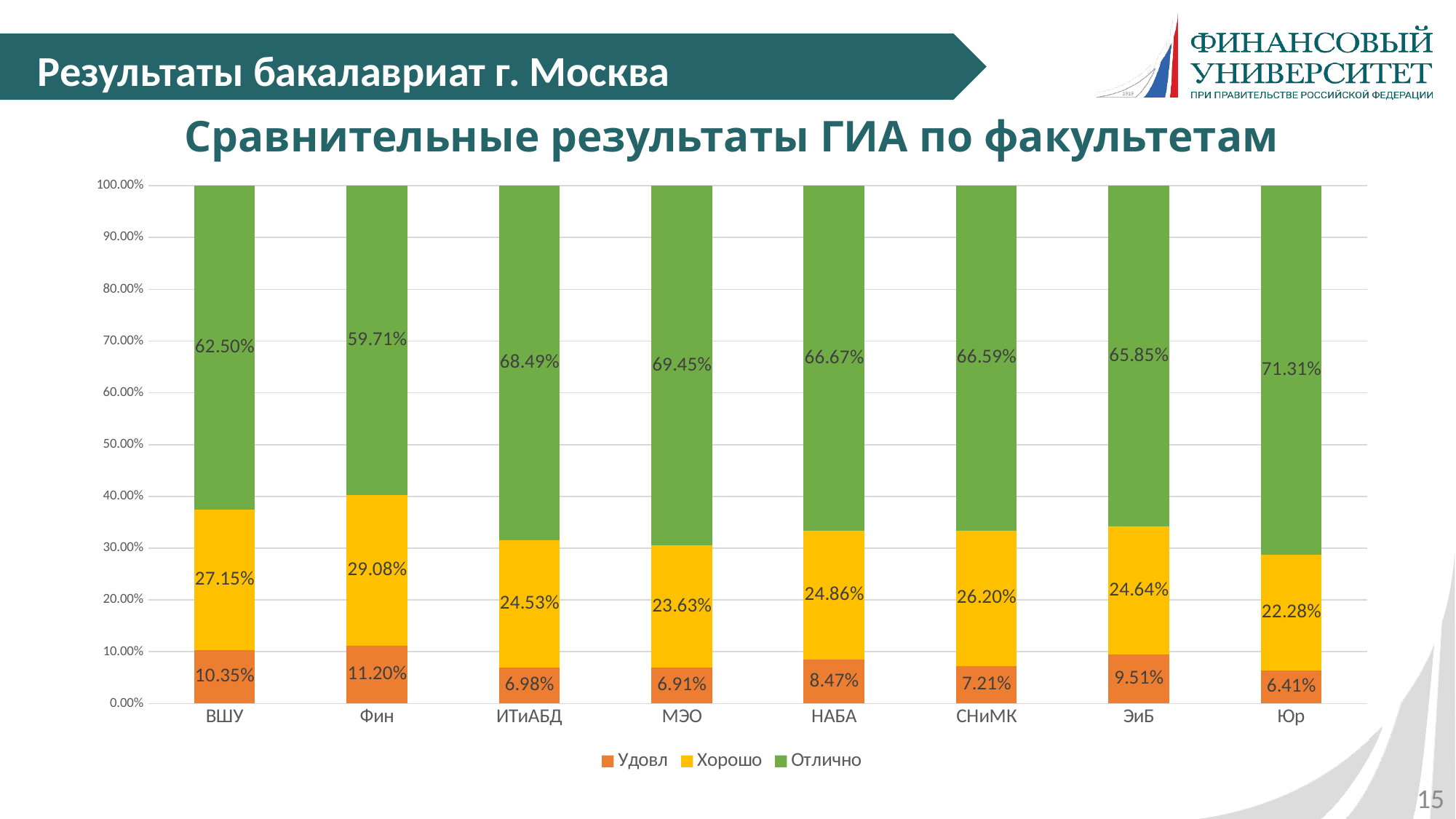
How many series does the legend list? 3 What is the total of the stacked bar for ВШУ? 100.00% What is the value of Удовл for Фин? 11.20% Which faculty has the highest Отлично share? Юр What is the value of Отлично for Юр? 71.31% Which is larger, the Хорошо value for ВШУ or for СНиМК? ВШУ Which faculty has the highest Удовл share? Фин Which faculty has the lowest Отлично share? Фин How many faculties are shown on the x axis? 8 What is the value of Хорошо for МЭО? 23.63% What is the difference between the Отлично values for Юр and Фин? 11.60% What kind of chart is shown on the slide? Stacked bar chart